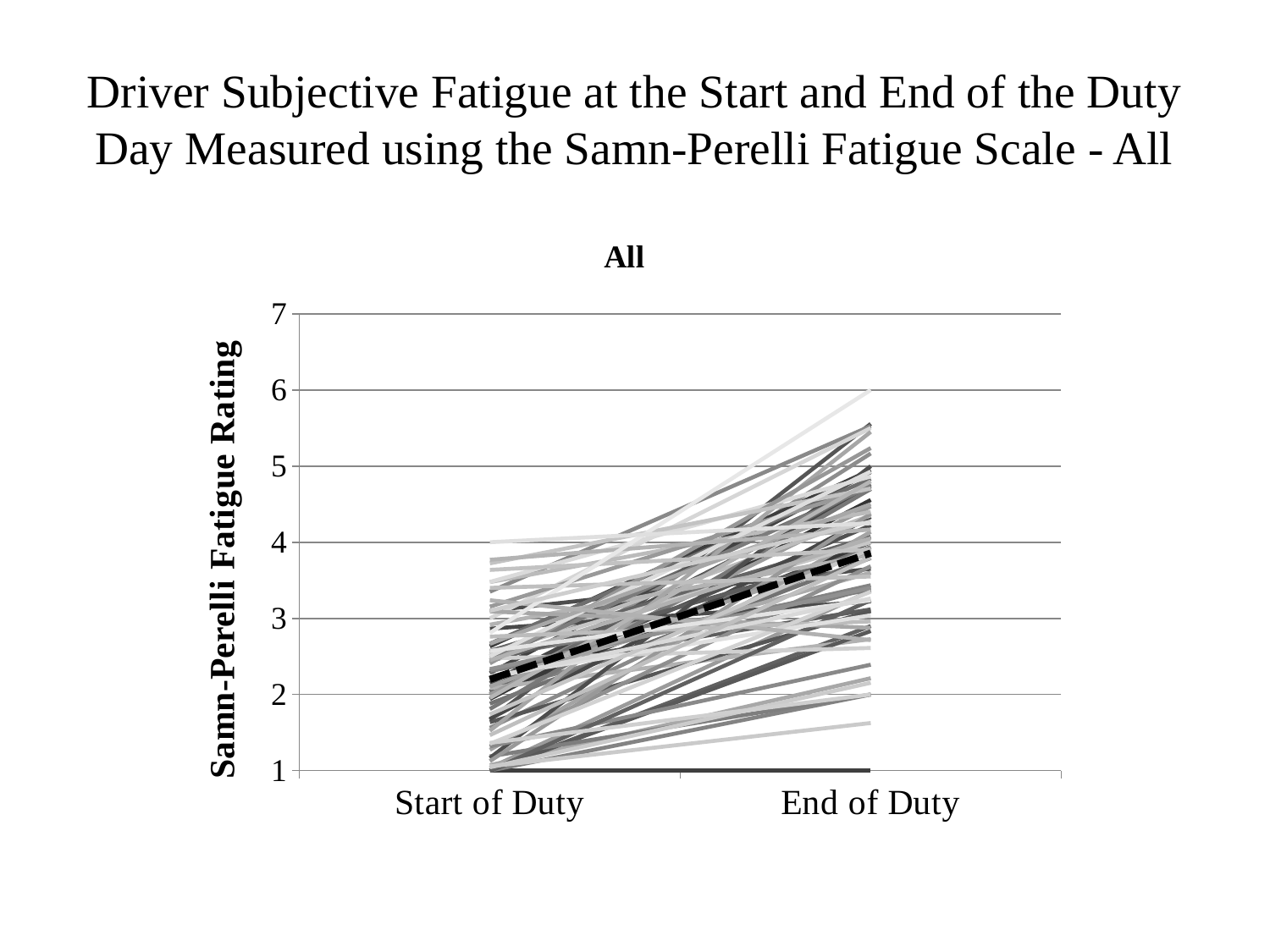
Is the dashed black line higher at Start of Duty or at End of Duty? End of Duty What is the highest tick value shown on the y axis of the chart? 7 Is the value of the dashed black line at End of Duty greater or less than 3? greater What is the label of the y axis of the chart? Samn-Perelli Fatigue Rating What are the two categories on the x axis of the chart? Start of Duty and End of Duty Is the value of the dashed black line at Start of Duty greater or less than 3? less Do the lines in the chart generally rise or fall from Start of Duty to End of Duty? rise What kind of chart is shown on the slide? line chart Is the value of the dashed black line at Start of Duty greater or less than 2? greater How many categories are shown on the x axis of the chart? 2